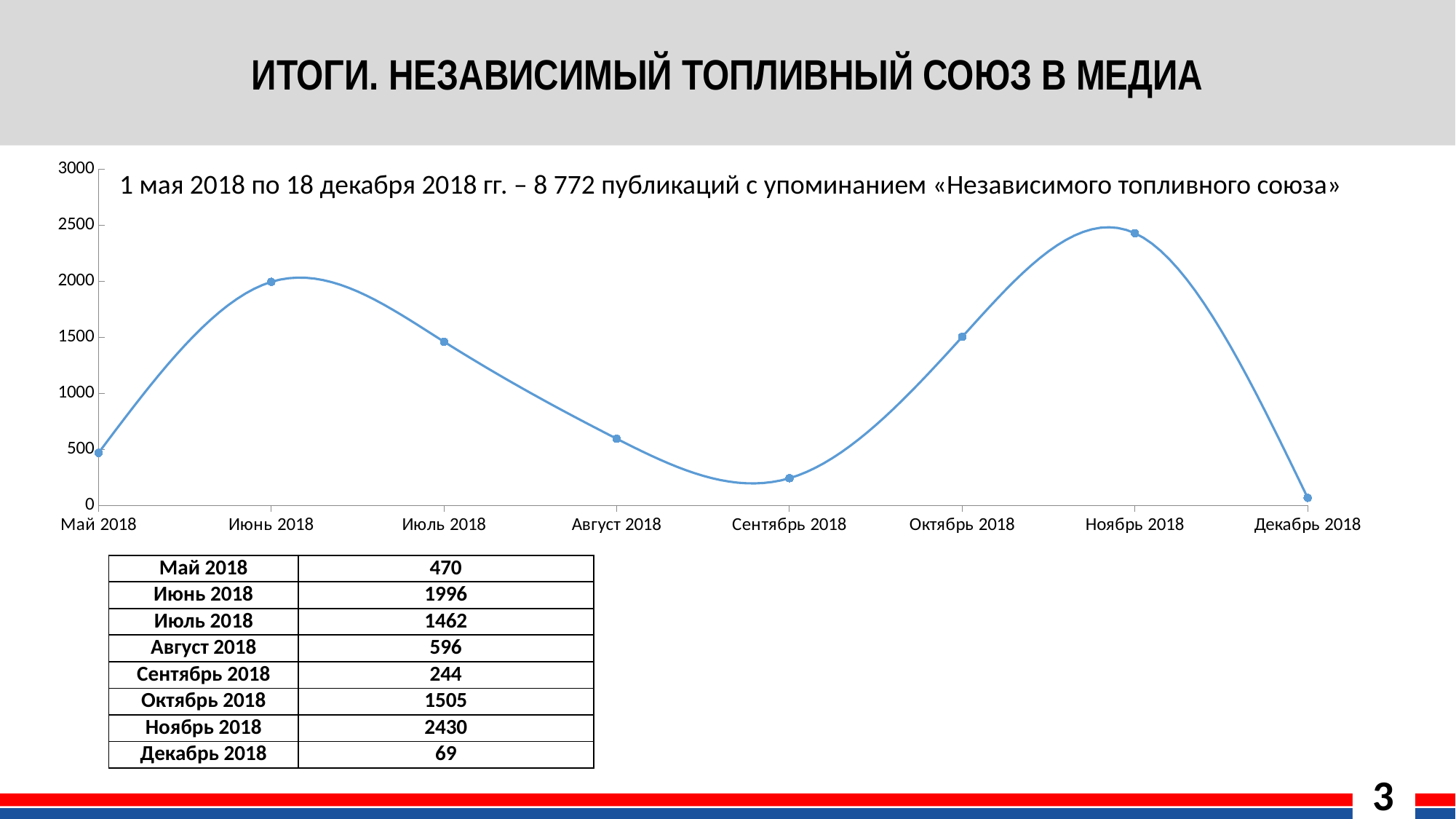
According to the text on the chart, how many publications mentioned the «Независимый топливный союз» from 1 May 2018 to 18 December 2018? 8 772 How many months (data points) are plotted on the chart? 8 Is the value for Август 2018 greater or less than 500? greater What is the value for Декабрь 2018? 69 Which is larger, the value for Октябрь 2018 or Июль 2018? Октябрь 2018 What is the difference between the values for Ноябрь 2018 and Июнь 2018? 434 What is the value for Сентябрь 2018? 244 Which month has the highest value? Ноябрь 2018 Do the values rise or fall from Сентябрь 2018 to Ноябрь 2018? rise What kind of chart is shown on the slide? line chart Which month has the lowest value? Декабрь 2018 What is the value for Июнь 2018? 1996